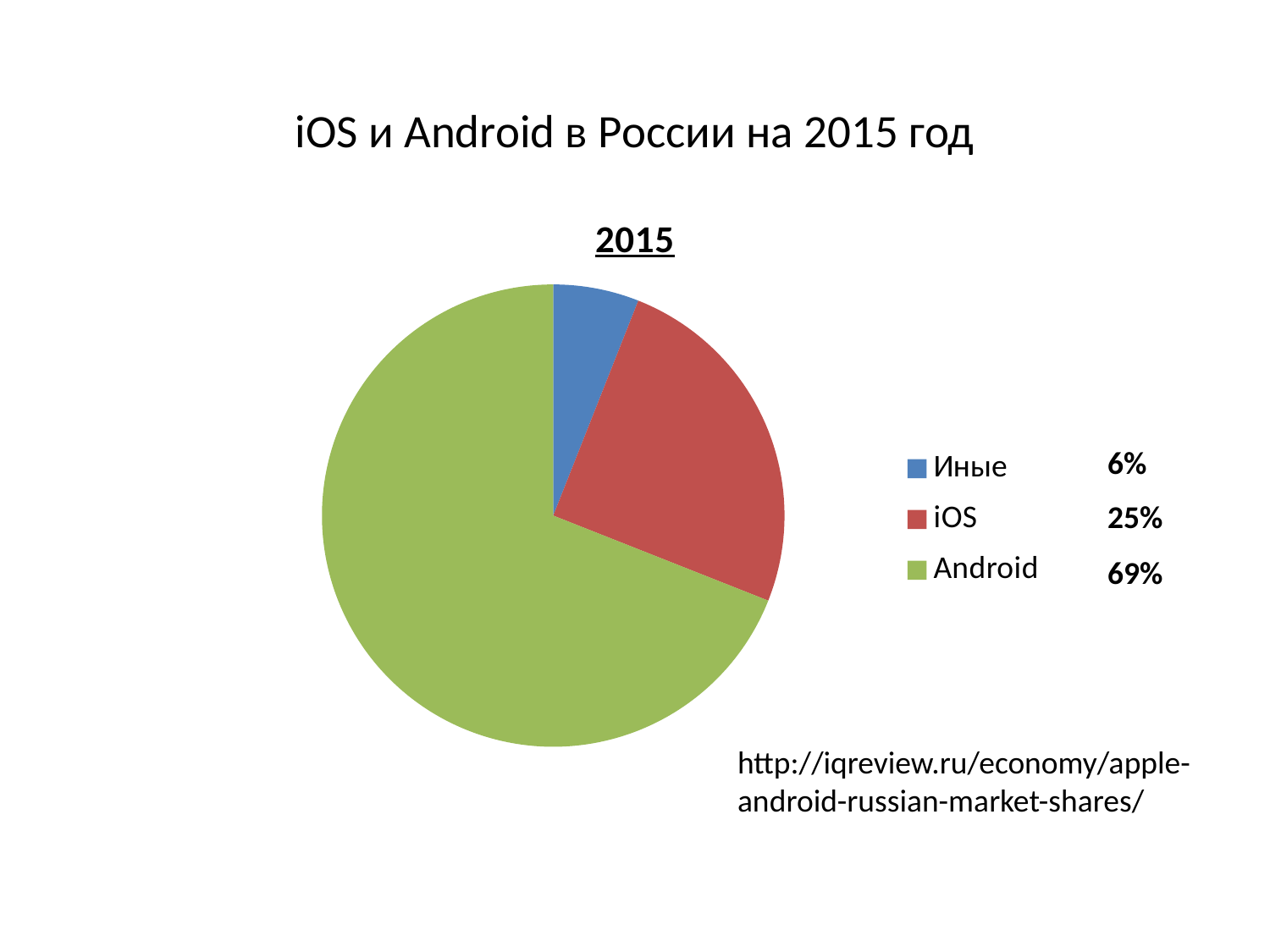
What share of the pie does Иные have? 6% Which category has the smallest slice? Иные What is the difference between the iOS share and the Иные share? 19% What share of the pie does iOS have? 25% Which is larger, the iOS slice or the Иные slice? iOS Which category has the largest slice? Android What is the difference between the Android share and the iOS share? 44% What share of the pie does Android have? 69% What kind of chart is shown on the slide? pie chart What colour is the Android slice? green What is the chart's title? 2015 How many slices does the pie chart have? 3